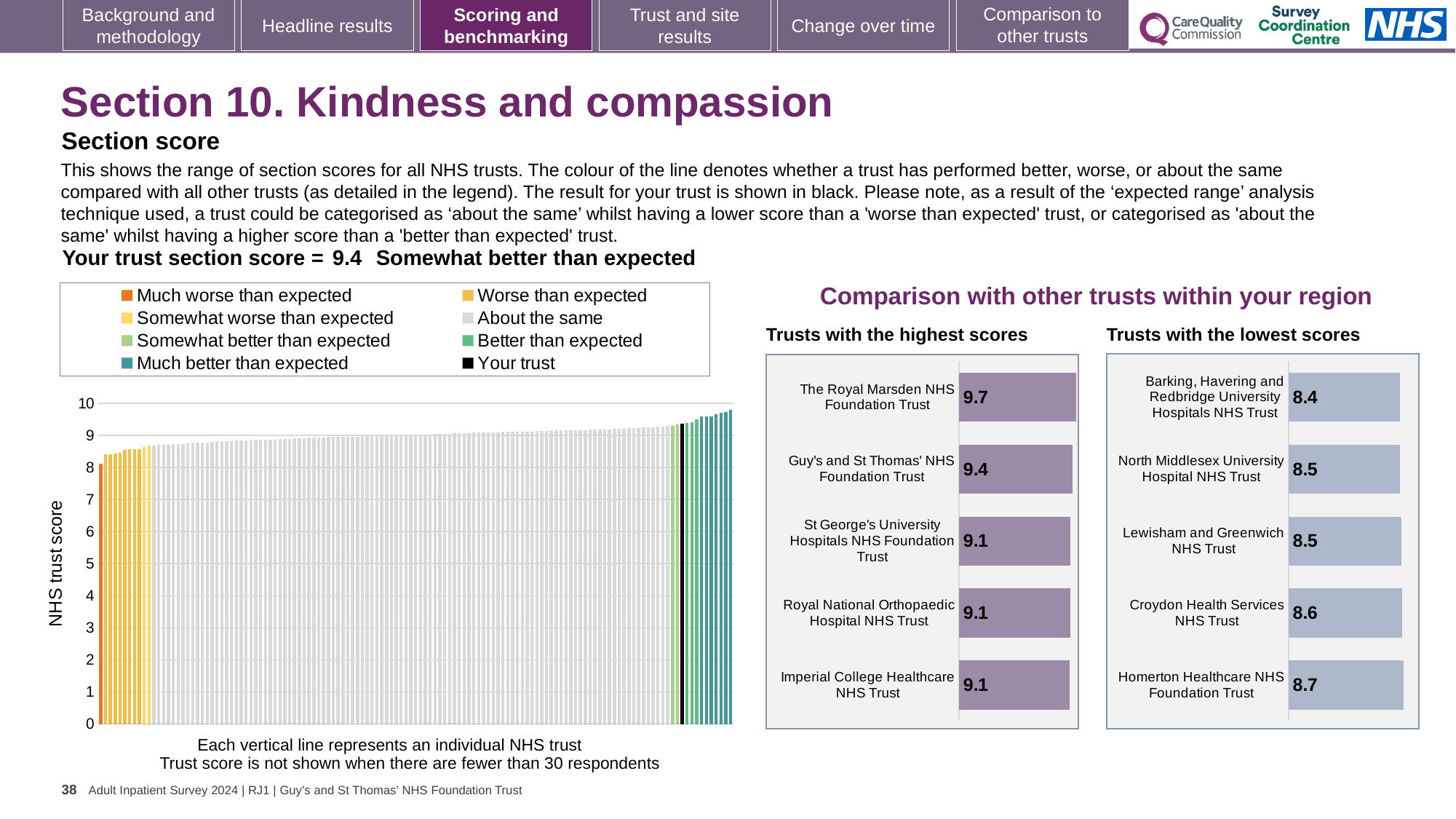
In the 'Trusts with the highest scores' chart, what is the difference between the scores of The Royal Marsden NHS Foundation Trust and Imperial College Healthcare NHS Trust? 0.6 In the 'Trusts with the highest scores' chart, which has the larger score: The Royal Marsden NHS Foundation Trust or Guy's and St Thomas' NHS Foundation Trust? The Royal Marsden NHS Foundation Trust In the 'Trusts with the highest scores' chart, what is the score for The Royal Marsden NHS Foundation Trust? 9.7 In the 'Trusts with the lowest scores' chart, how many trusts are shown? 5 What kind of chart is the main chart on the left showing NHS trust scores? Bar chart In the main chart on the left showing NHS trust scores, do the values rise or fall from left to right? Rise In the 'Trusts with the lowest scores' chart, which trust has the lowest score? Barking, Havering and Redbridge University Hospitals NHS Trust In the main chart on the left showing NHS trust scores, how many entries does the legend list? 8 In the 'Trusts with the lowest scores' chart, what is the score for Croydon Health Services NHS Trust? 8.6 In the 'Trusts with the highest scores' chart, which trust has the highest score? The Royal Marsden NHS Foundation Trust In the 'Trusts with the lowest scores' chart, what is the difference between the scores of Homerton Healthcare NHS Foundation Trust and Barking, Havering and Redbridge University Hospitals NHS Trust? 0.3 In the main chart on the left, is the value for the black bar representing your trust greater or less than 9? greater